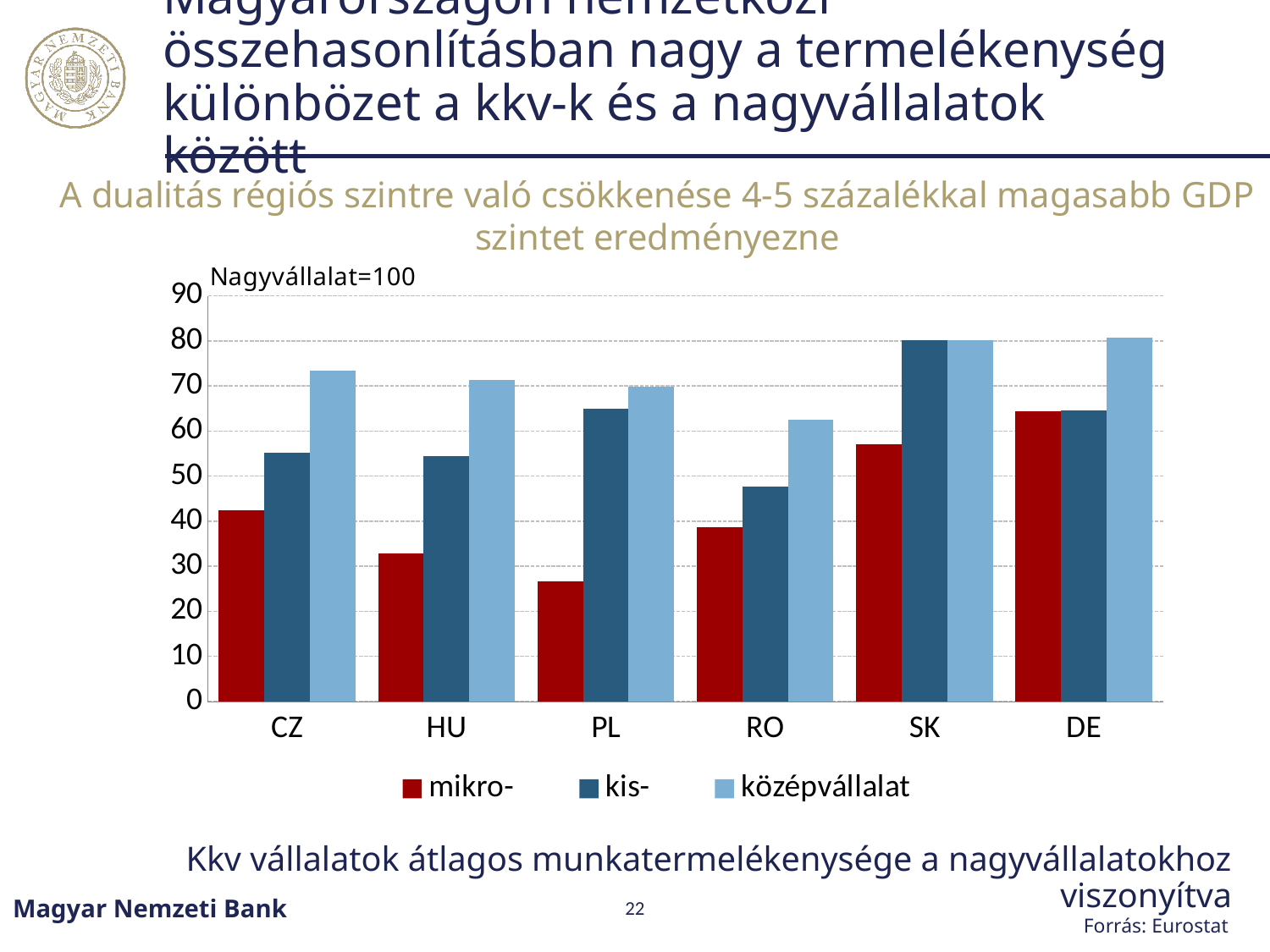
How many series does the legend list? 3 Which country has the highest value for the mikro- series? DE Is the kis- value for SK greater or less than 70? greater Which country has the lowest value for the kis- series? RO What reference note is printed above the y axis of the chart? Nagyvállalat=100 Is the mikro- value for HU greater or less than 40? less Is the kis- value for PL greater or less than 60? greater Which country has the lowest value for the mikro- series? PL What kind of chart is shown on the slide? bar chart Which is larger, the mikro- value for PL or the mikro- value for RO? RO Which country has the lowest value for the középvállalat series? RO How many countries are shown on the x axis of the chart? 6